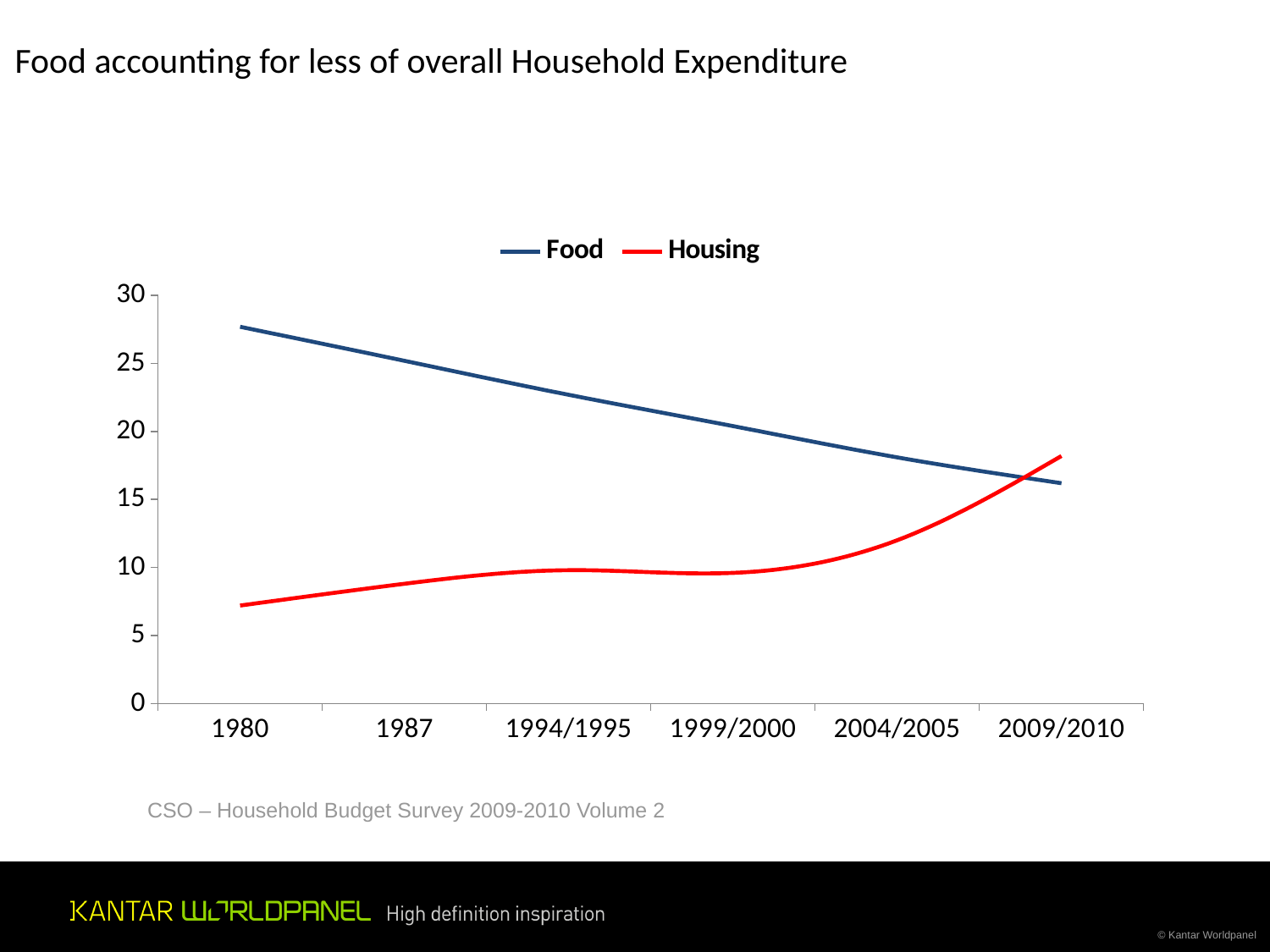
Is the value for Food in 2009/2010 greater or less than 20? less Does the Housing series rise or fall overall from 1980 to 2009/2010? rise In which period is the Food series at its highest? 1980 What kind of chart is shown on the slide? line chart How many series does the legend list? 2 How many time periods are shown on the x axis? 6 Is the value for Food in 1980 greater or less than 25? greater In 2009/2010, which series has the higher value, Food or Housing? Housing Does the Food series rise or fall from 1980 to 2009/2010? fall Is the value for Housing in 2009/2010 greater or less than 15? greater In 1980, which series has the higher value, Food or Housing? Food